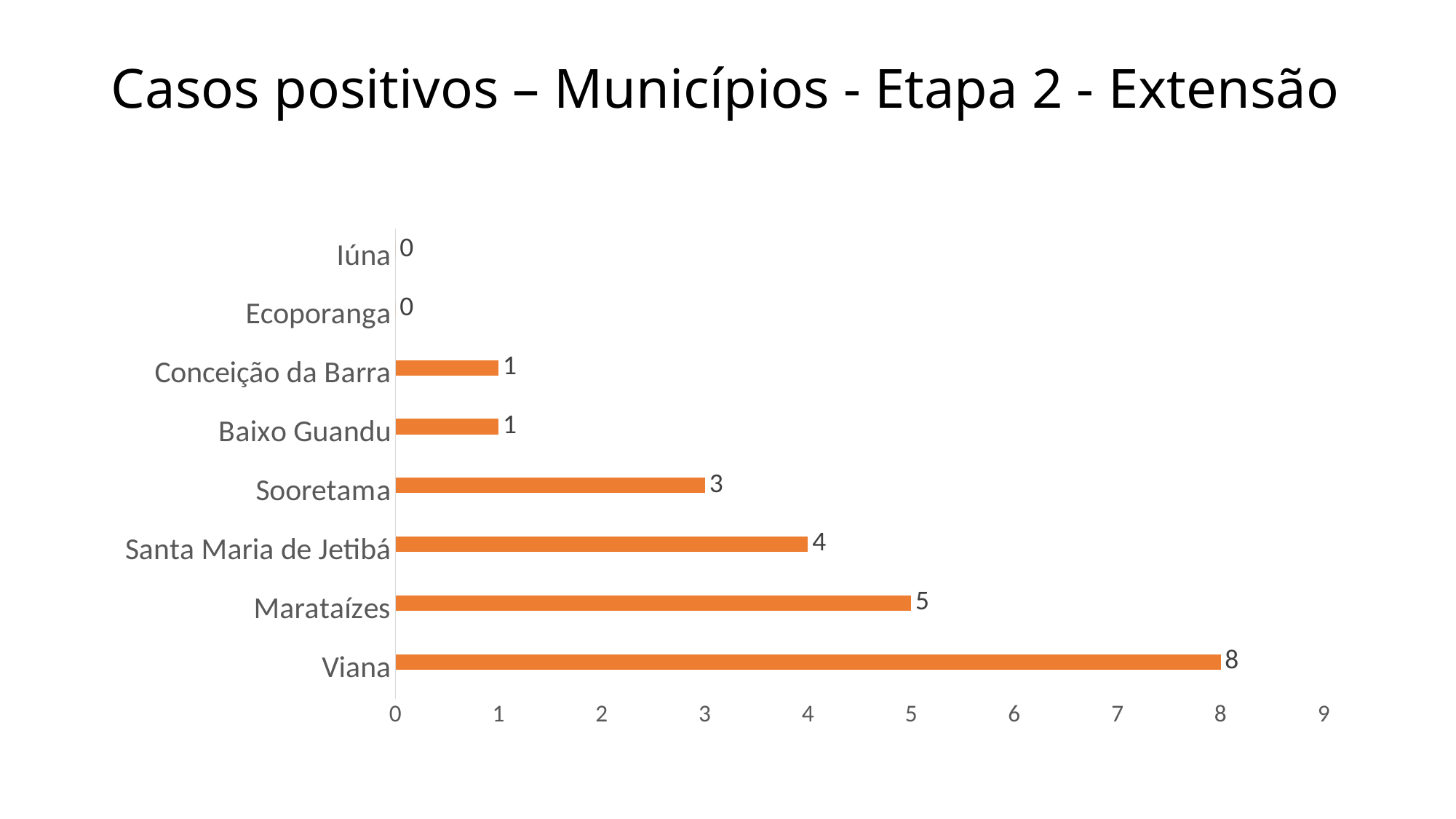
What is the value for Sooretama? 3 What kind of chart is shown on the slide? bar chart What is the value for Ecoporanga? 0 How many municipalities are shown on the chart? 8 How many municipalities have a value of 0? 2 Which municipality has the highest value? Viana What is the value for Viana? 8 What is the value for Santa Maria de Jetibá? 4 Is the value for Marataízes greater or less than 4? greater Which is larger, the value for Sooretama or the value for Baixo Guandu? Sooretama What is the title of the slide? Casos positivos – Municípios - Etapa 2 - Extensão What is the difference between the values for Viana and Marataízes? 3